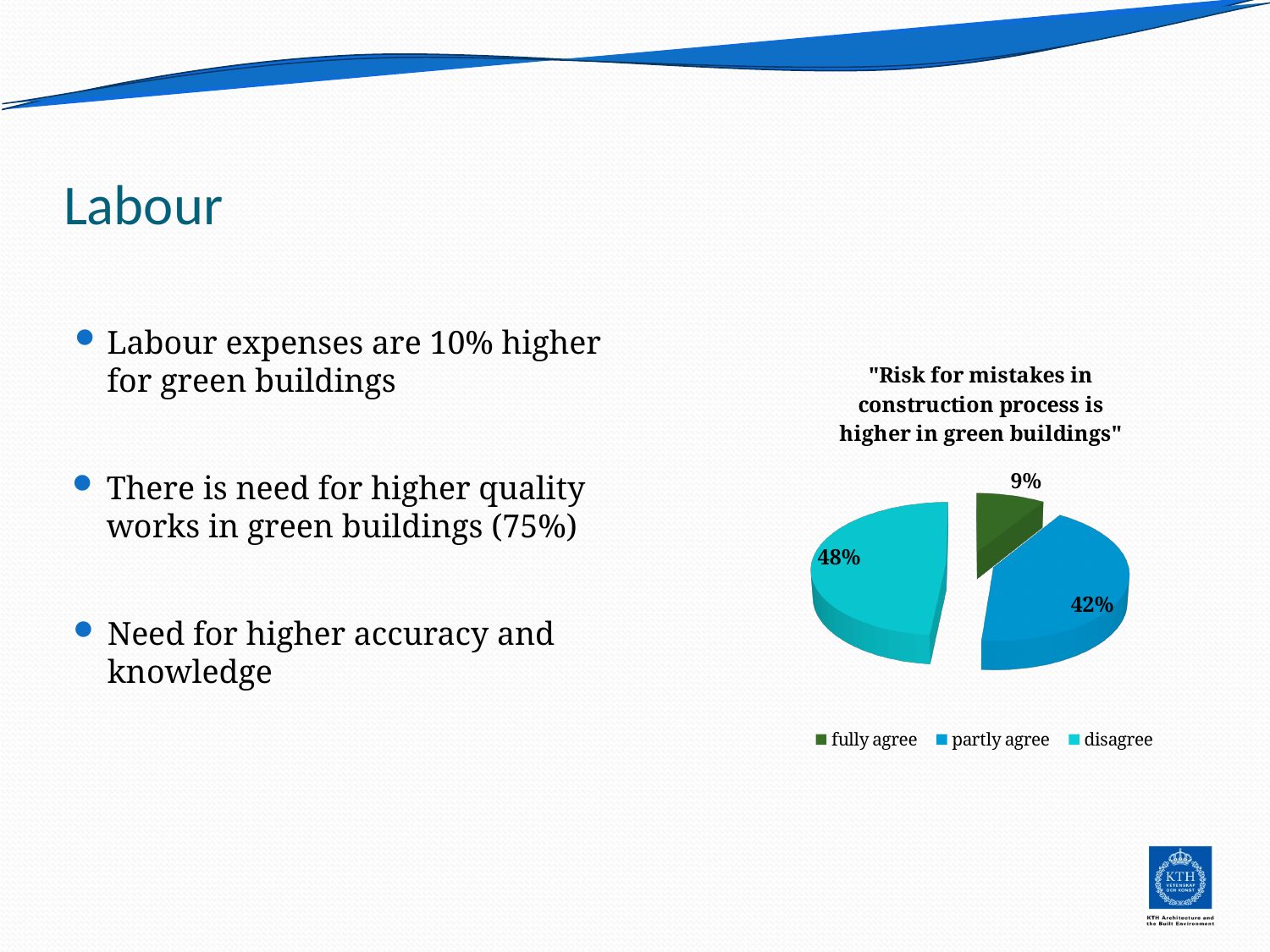
What percentage of respondents fully agree that the risk for mistakes in the construction process is higher in green buildings? 9% Which response category has the smallest share of the pie? fully agree What kind of chart is shown on the slide? pie chart Which response category has the largest share of the pie? disagree What percentage of respondents disagree? 48% Which is larger, the share for partly agree or the share for fully agree? partly agree How many slices does the pie chart have? 3 What is the difference in percentage points between the disagree and partly agree slices? 6 What colour is the disagree slice in the pie chart? light blue (cyan) What is the title of the pie chart? "Risk for mistakes in construction process is higher in green buildings" How many categories does the legend of the pie chart list? 3 What percentage of respondents partly agree? 42%